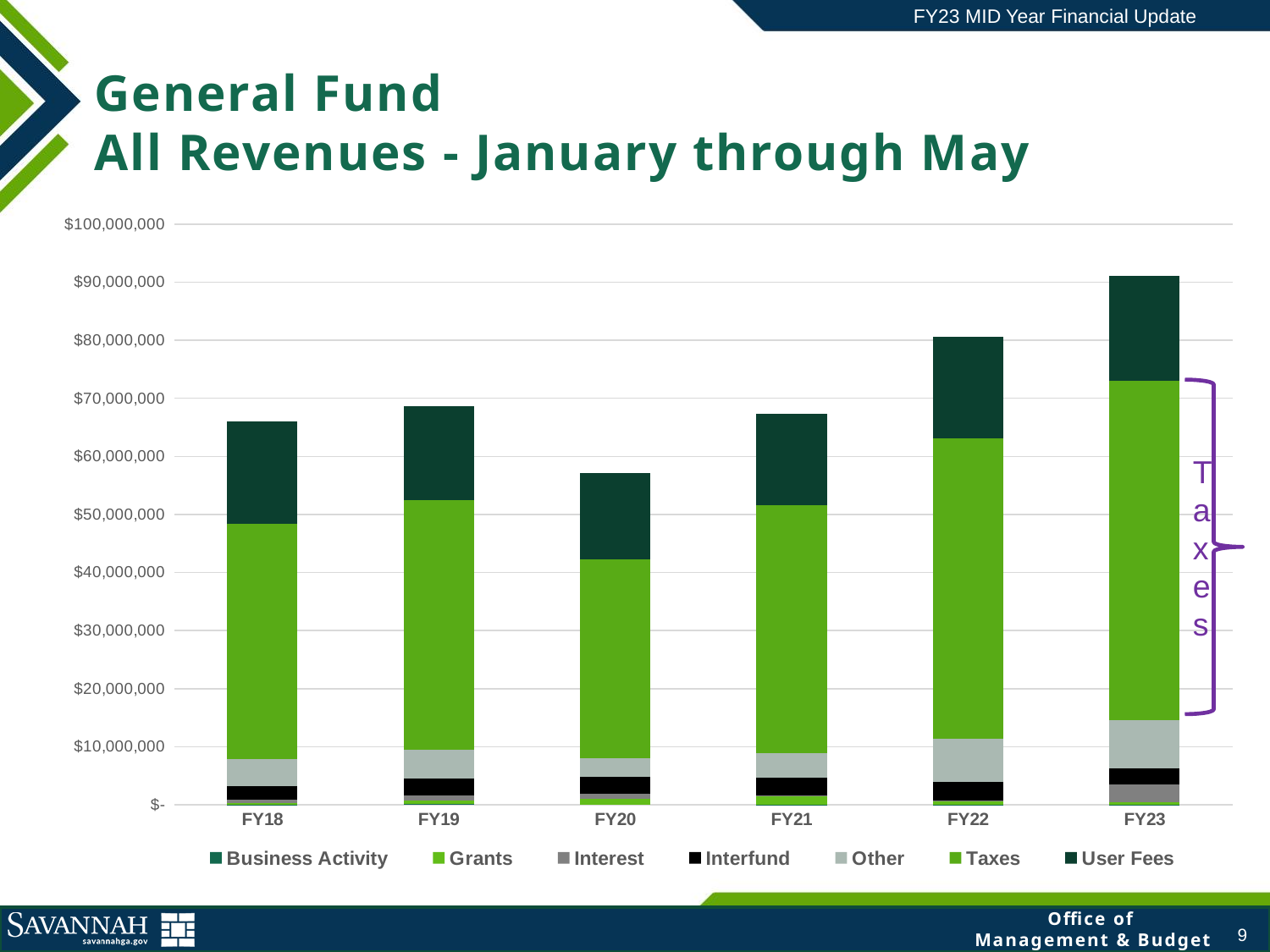
Which series is highlighted by the purple bracket annotation next to the FY23 bar? Taxes How many series does the chart's legend list? 7 Do the total revenue bars rise or fall from FY20 through FY23? rise Is the total revenue bar for FY18 greater or less than $60,000,000? greater Which fiscal year has the highest total revenue bar? FY23 Which has the larger total revenue bar, FY22 or FY21? FY22 What is the title of the chart on the slide? General Fund All Revenues - January through May Which fiscal year has the lowest total revenue bar? FY20 Is the total revenue bar for FY20 greater or less than $60,000,000? less Is the total revenue bar for FY21 greater or less than $70,000,000? less What kind of chart is shown on the slide? Stacked bar chart How many fiscal years are shown on the x axis of the chart? 6